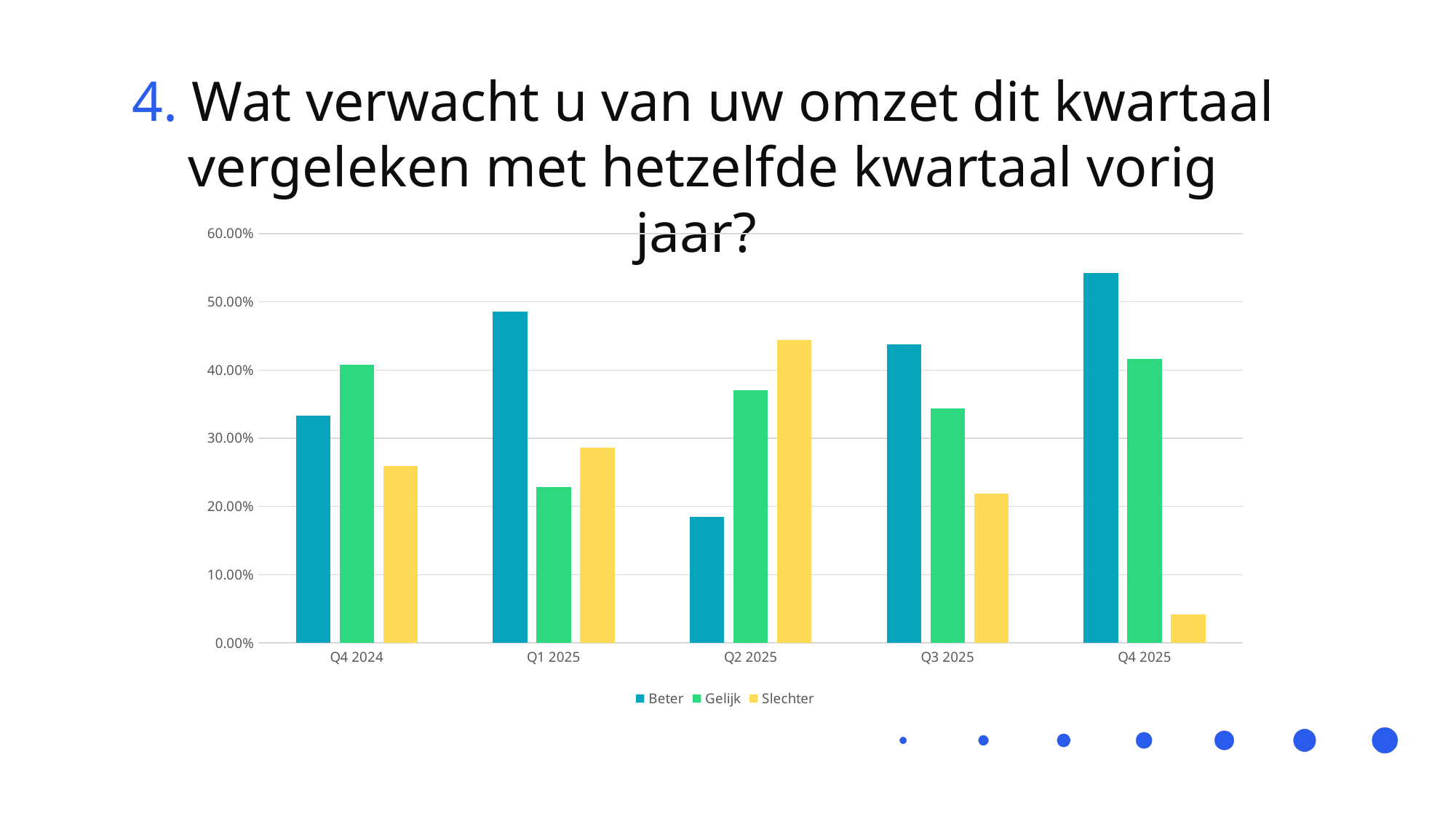
In which quarter is the value for Beter the lowest? Q2 2025 What kind of chart is shown on the slide? bar chart Is the value for Slechter in Q4 2025 greater or less than 10%? less In which quarter is the value for Slechter the lowest? Q4 2025 In which quarter is the value for Beter the highest? Q4 2025 Is the value for Beter in Q1 2025 greater or less than 40%? greater How many quarters are shown on the x axis? 5 What are the three entries in the legend? Beter, Gelijk, Slechter In Q4 2024, which is larger: Beter or Gelijk? Gelijk Is the value for Beter in Q2 2025 greater or less than 20%? less In Q2 2025, which is larger: Beter or Slechter? Slechter How many series does the legend list? 3